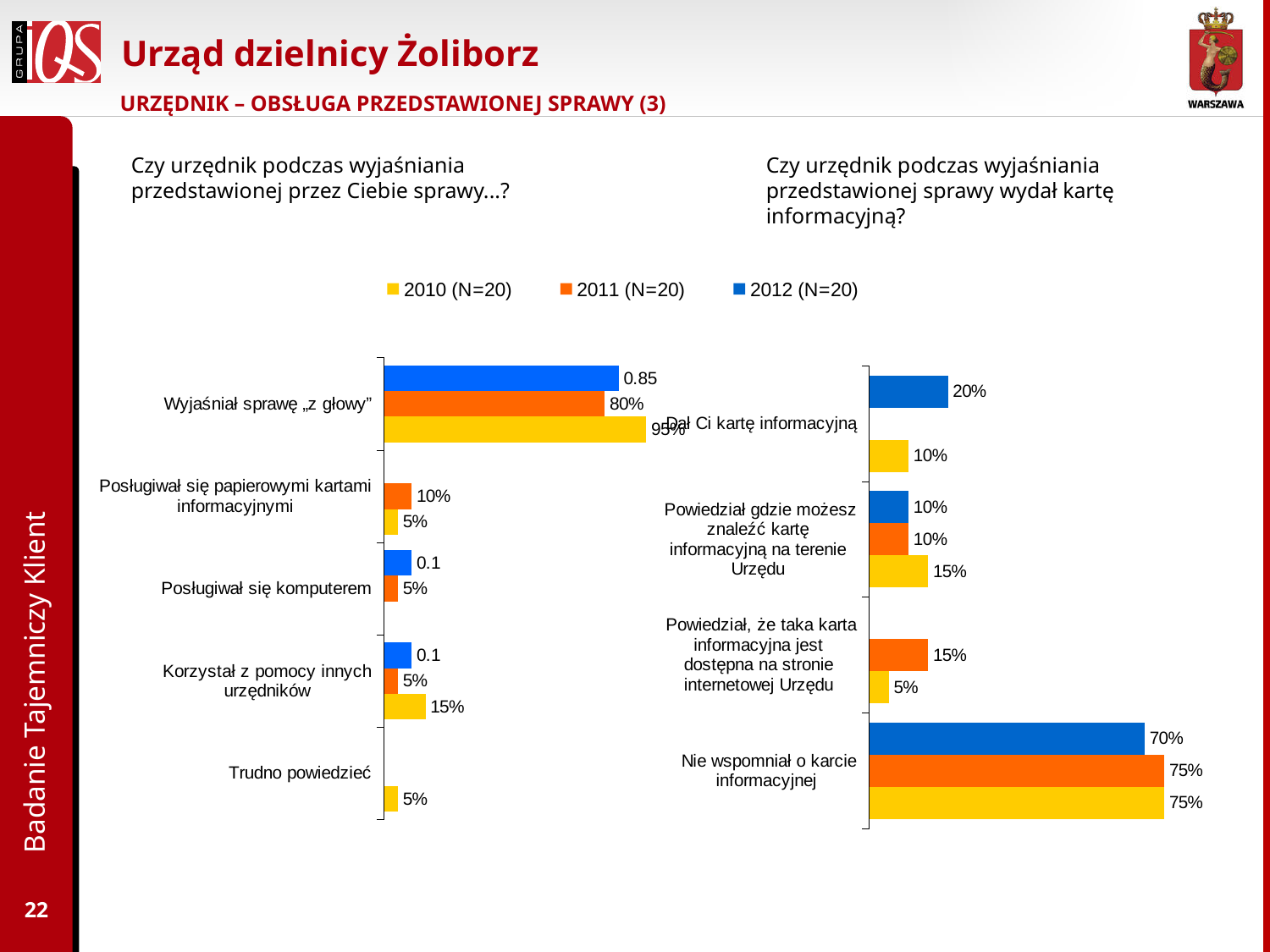
How many categories does the right chart show? 4 In the right chart, which category has the highest 2012 (N=20) value? Nie wspomniał o karcie informacyjnej In the right chart, what is the 2012 (N=20) value for "Dał Ci kartę informacyjną"? 20% In the left chart, which is larger for "Posługiwał się papierowymi kartami informacyjnymi": the 2011 (N=20) value or the 2010 (N=20) value? 2011 (N=20) In the left chart, what is the 2011 (N=20) value for "Wyjaśniał sprawę „z głowy""? 80% In the right chart, what is the difference between the 2010 (N=20) and 2012 (N=20) values for "Nie wspomniał o karcie informacyjnej"? 5% What kind of chart is the left chart? Bar chart In the left chart, which category has the highest 2010 (N=20) value? Wyjaśniał sprawę „z głowy" In the left chart, what is the 2012 (N=20) value for "Posługiwał się komputerem"? 0.1 How many series does the legend list? 3 In the left chart, what is the 2010 (N=20) value for "Korzystał z pomocy innych urzędników"? 15% In the right chart, what is the 2011 (N=20) value for "Nie wspomniał o karcie informacyjnej"? 75%